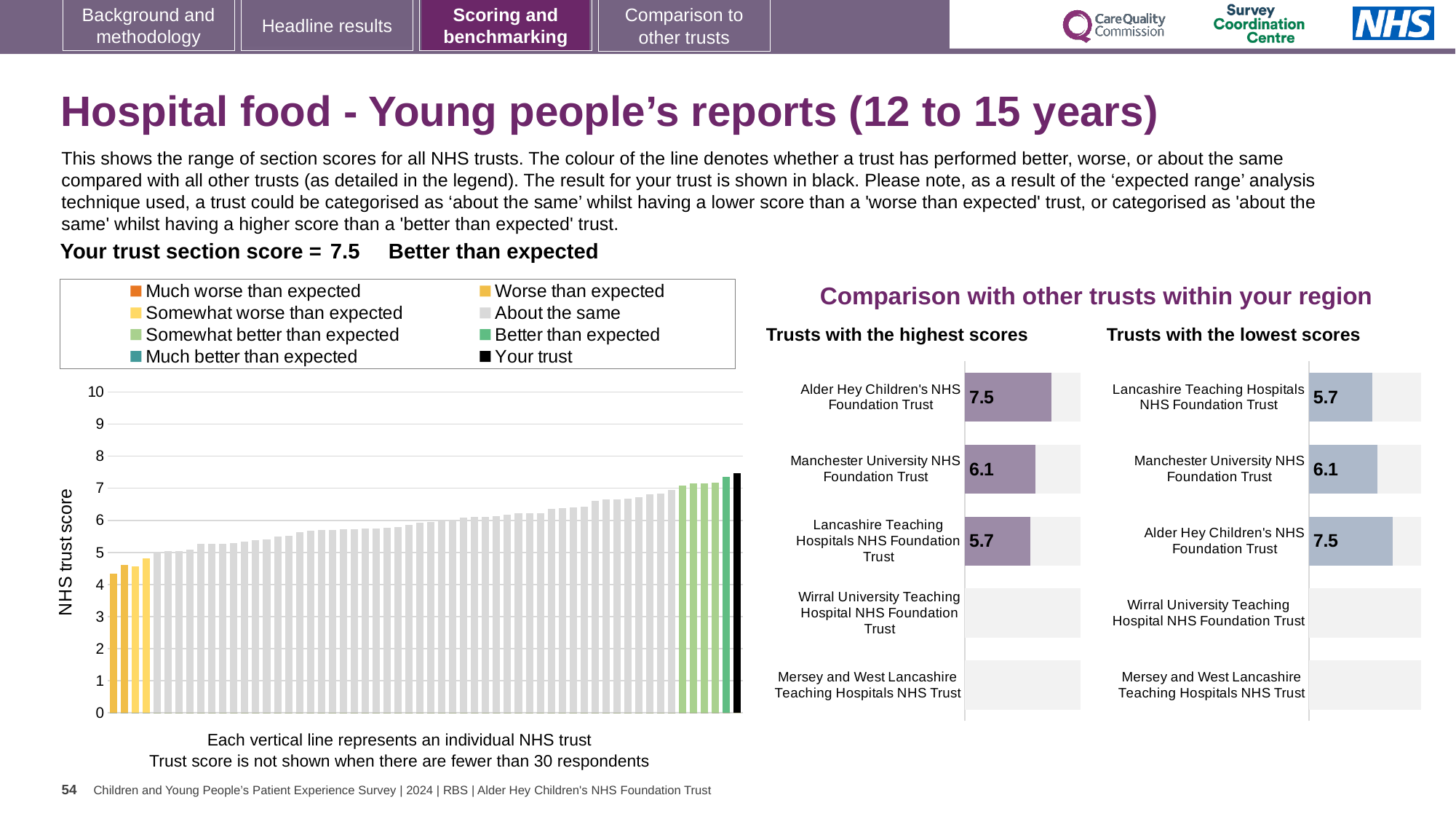
In the large chart on the left, is the value of the leftmost bar greater or less than 5? less What kind of chart is the large chart on the left of the slide? bar chart In the 'Trusts with the lowest scores' chart, how many trusts are listed? 5 In the 'Trusts with the highest scores' chart, what is the score for Alder Hey Children's NHS Foundation Trust? 7.5 In the 'Trusts with the lowest scores' chart, what is the score for Lancashire Teaching Hospitals NHS Foundation Trust? 5.7 In the 'Trusts with the highest scores' chart, which trust has the highest score? Alder Hey Children's NHS Foundation Trust In the 'Trusts with the highest scores' chart, what is the score for Manchester University NHS Foundation Trust? 6.1 In the large chart on the left, do the bar values rise or fall from left to right? rise In the large chart on the left, what is the label on the vertical axis? NHS trust score In the 'Trusts with the highest scores' chart, what is the difference between the scores of Alder Hey Children's NHS Foundation Trust and Lancashire Teaching Hospitals NHS Foundation Trust? 1.8 In the large chart on the left, is the value of the black bar (your trust) greater or less than 7? greater How many entries does the legend above the large chart on the left list? 8